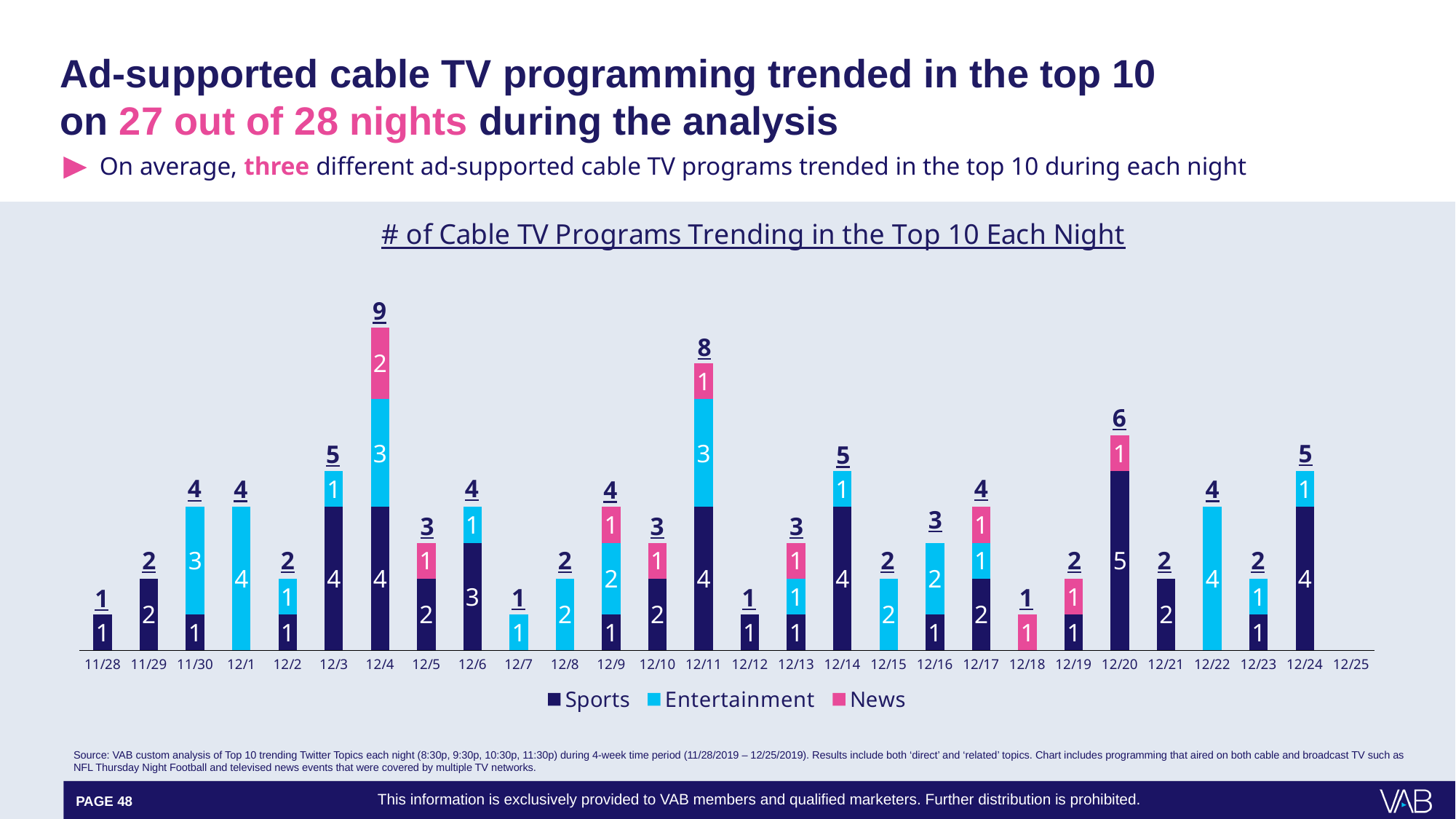
How many News programs trended in the top 10 on 12/4? 2 What is the total number of programs trending on 12/11? 8 Which date on the x axis has no bar at all? 12/25 How many series does the legend list? 3 What is the difference between the total for 12/4 and the total for 12/11? 1 How many dates are shown on the x axis? 28 How many Entertainment programs trended in the top 10 on 12/22? 4 How many Sports programs trended in the top 10 on 12/20? 5 What is the title of the chart? # of Cable TV Programs Trending in the Top 10 Each Night What kind of chart is shown on the slide? Stacked bar chart Which night has a larger total, 12/3 or 12/6? 12/3 Which night has the highest total number of cable TV programs trending in the top 10? 12/4